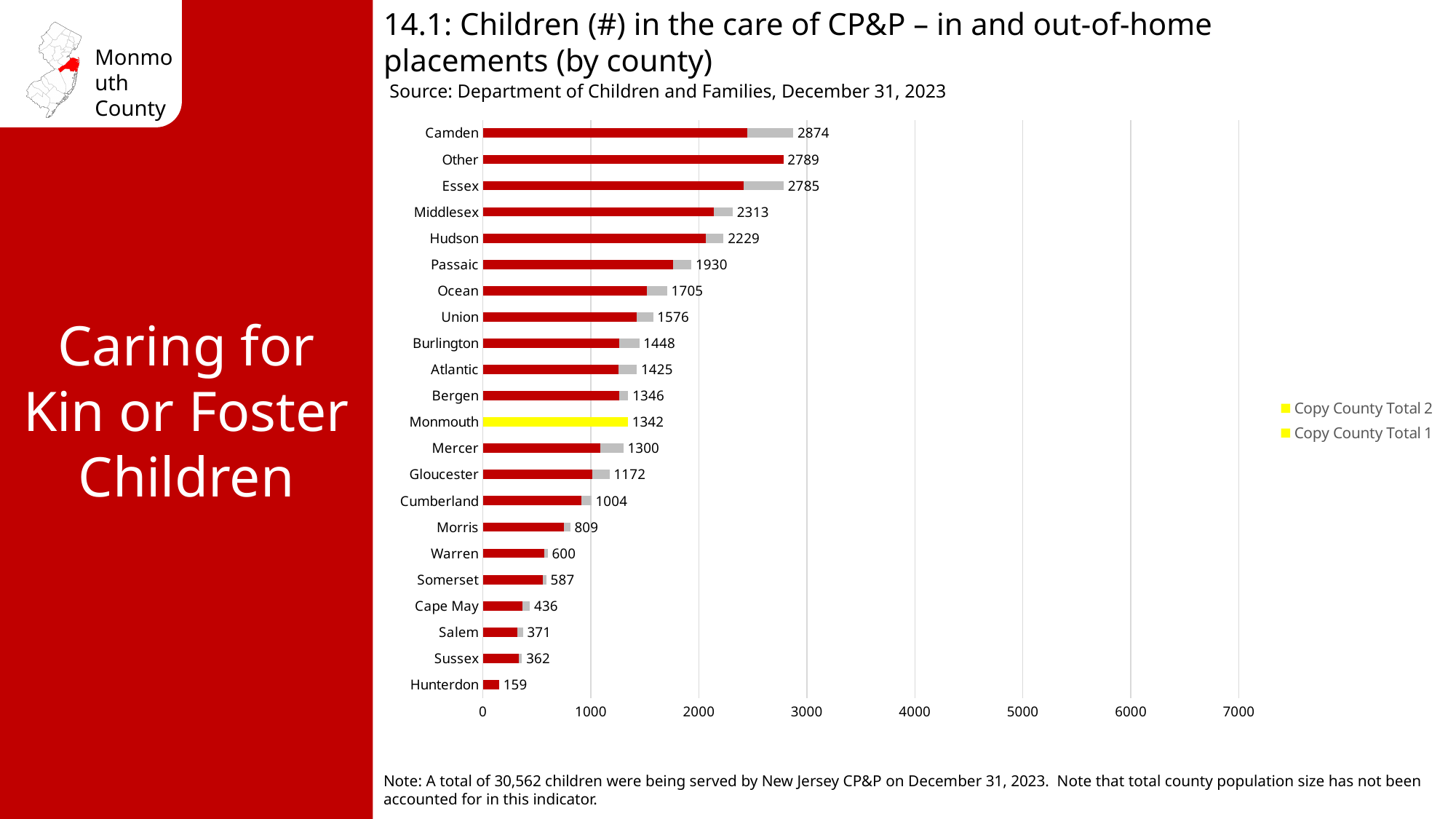
Which has a larger value, Passaic or Ocean? Passaic How many series does the legend list? 2 What value is shown for Cumberland County? 1004 What is the difference between the values for Camden and Essex? 89 What is the difference between the values for Ocean and Union? 129 What kind of chart is shown on the slide? bar chart Which county has the lowest number of children in the care of CP&P? Hunterdon What is the total number of children in the care of CP&P for Monmouth County? 1342 Which county has the highest number of children in the care of CP&P? Camden How many counties (categories) are shown on the chart? 22 Is the value for Middlesex greater or less than 2000? greater What value is shown for Hudson County? 2229